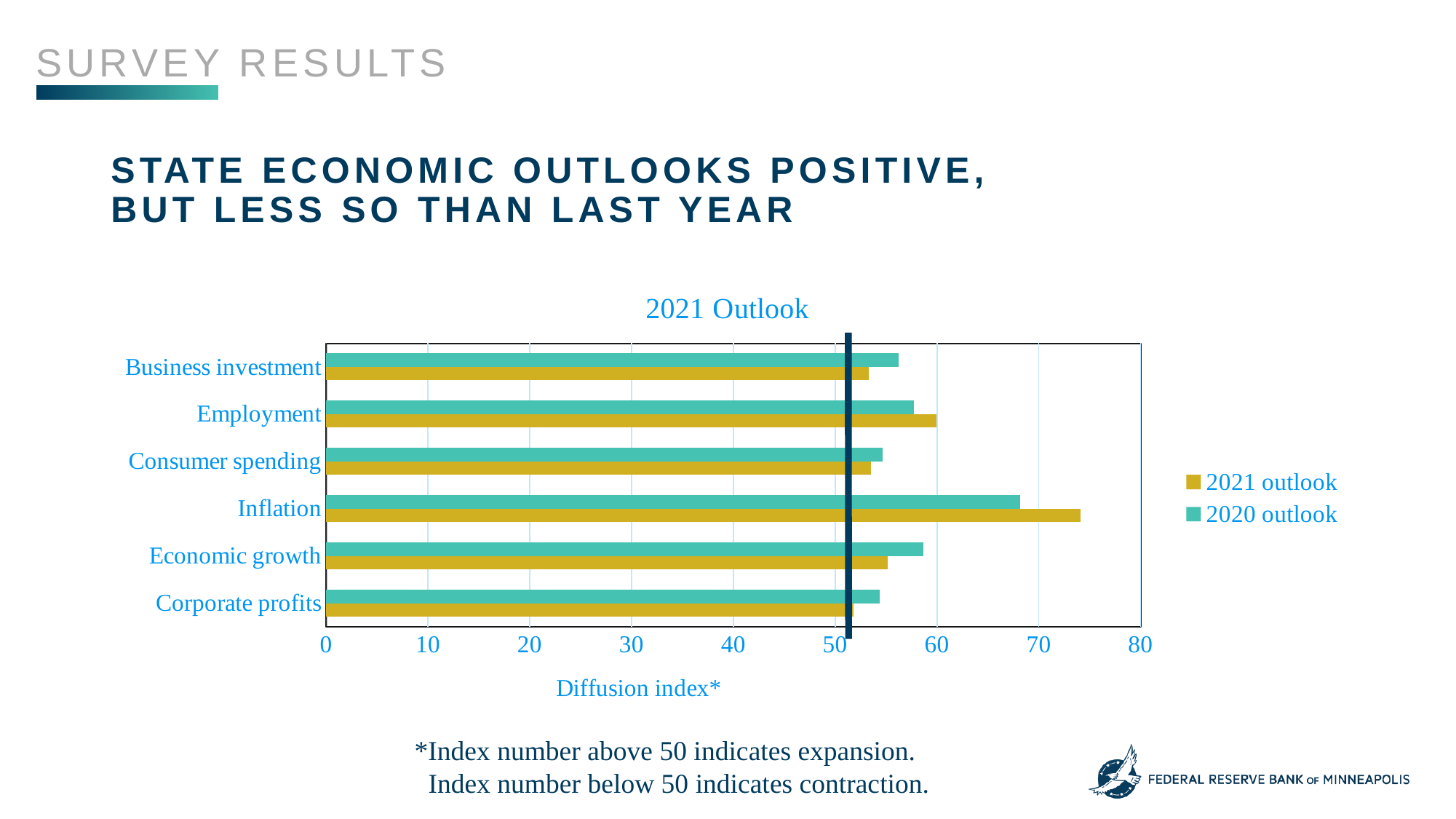
For Economic growth, which is larger: the 2021 outlook or the 2020 outlook? 2020 outlook Is the 2020 outlook value for Inflation greater or less than 70? less Which category has the highest value for the 2021 outlook series? Inflation What is the label on the horizontal axis of the chart? Diffusion index* Is the 2021 outlook value for Inflation greater or less than 70? greater Which category has the highest value for the 2020 outlook series? Inflation How many categories are shown on the chart? 6 How many series does the legend list? 2 For Inflation, which is larger: the 2021 outlook or the 2020 outlook? 2021 outlook What kind of chart is shown on the slide? bar chart Is the 2021 outlook value for Corporate profits greater or less than 50? greater